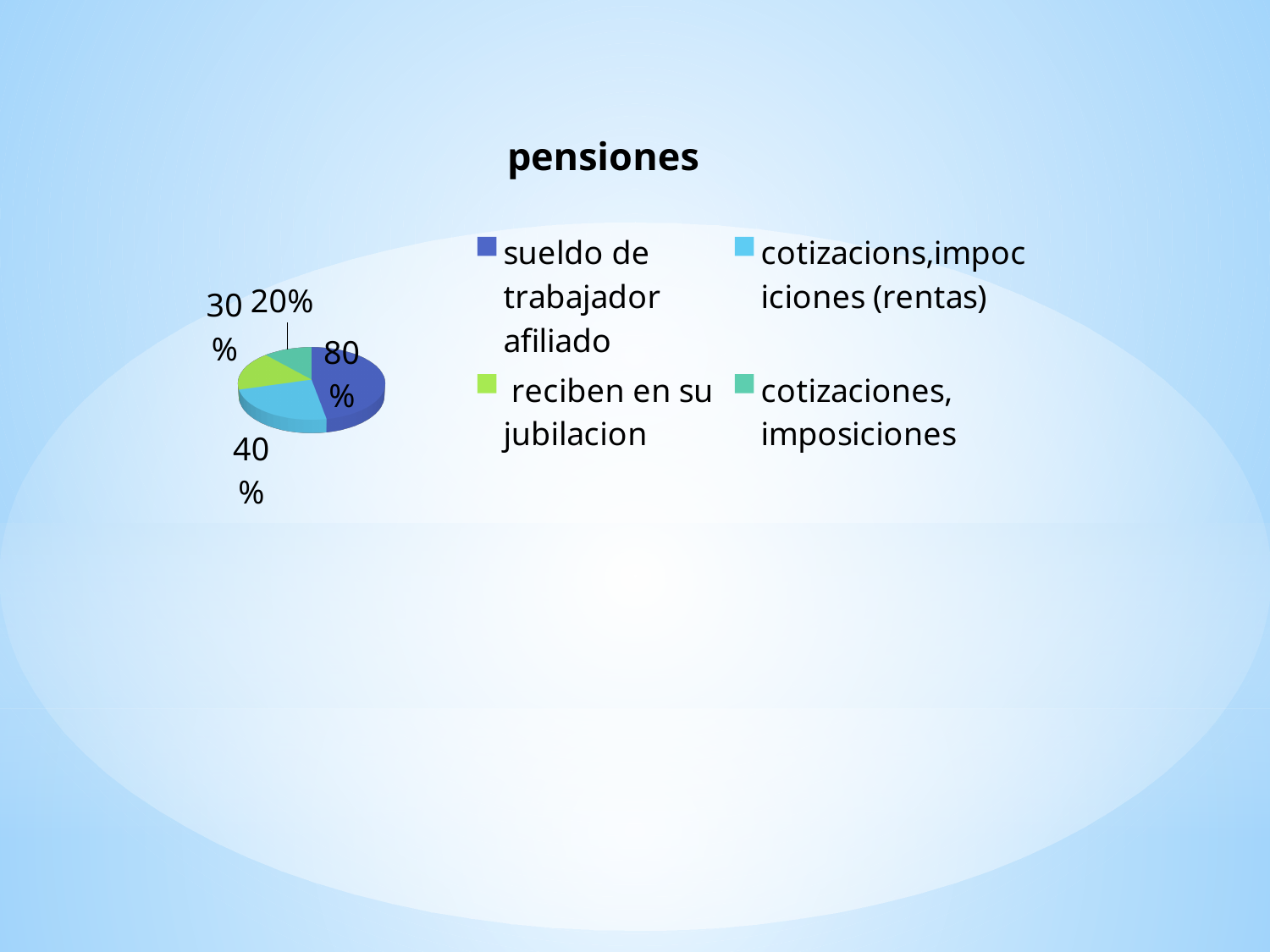
What value is labelled for the 'cotizacions,impociciones (rentas)' slice? 40% What value is labelled for the 'cotizaciones, imposiciones' slice? 20% How many slices does the pie chart have? 4 What value is labelled for the 'sueldo de trabajador afiliado' slice? 80% What type of chart is shown on the slide? pie chart Which category has the smallest slice of the pie? cotizaciones, imposiciones What value is labelled for the 'reciben en su jubilacion' slice? 30% What is the difference between the labelled values for 'sueldo de trabajador afiliado' and 'cotizacions,impociciones (rentas)'? 40% Which category has the largest slice of the pie? sueldo de trabajador afiliado Which is larger, the value for 'reciben en su jubilacion' or for 'cotizaciones, imposiciones'? reciben en su jubilacion What is the title of the chart? pensiones What colour is the 'reciben en su jubilacion' slice? green